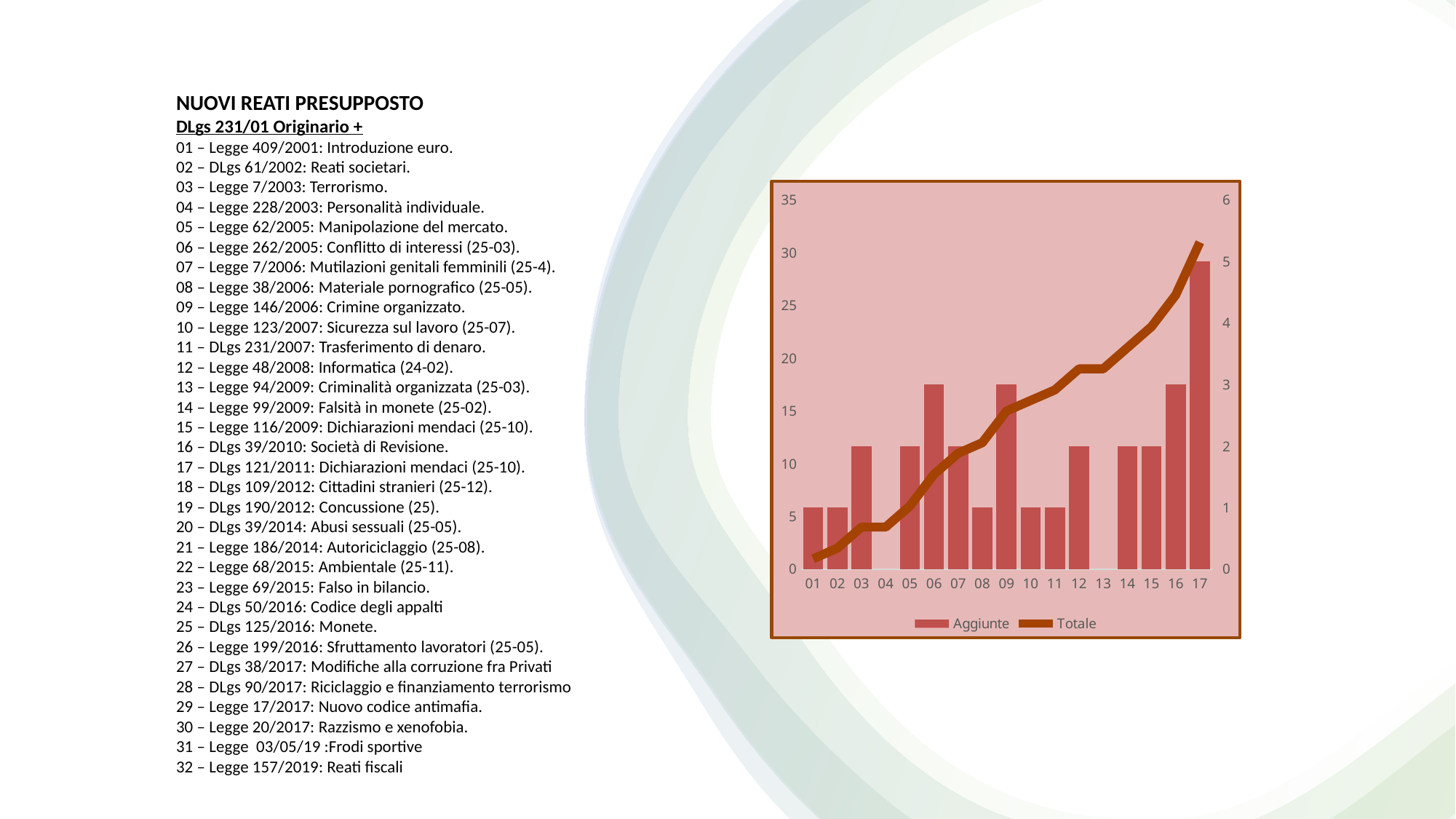
Is the Totale value for 17 greater or less than 25 on the left axis? greater Is the Aggiunte bar for 01 greater or less than 2 on the right axis? less Is the Totale value for 01 greater or less than 5 on the left axis? less Does the Totale line rise or fall from 01 to 17? It rises Which category has the tallest Aggiunte bar? 17 How many series does the chart legend list? 2 What are the two series named in the chart legend? Aggiunte and Totale Which has the larger Aggiunte bar, 16 or 17? 17 Which has the larger Aggiunte bar, 06 or 08? 06 What kind of chart is shown on the slide? A combination bar and line chart How many categories are shown along the x axis of the chart? 17